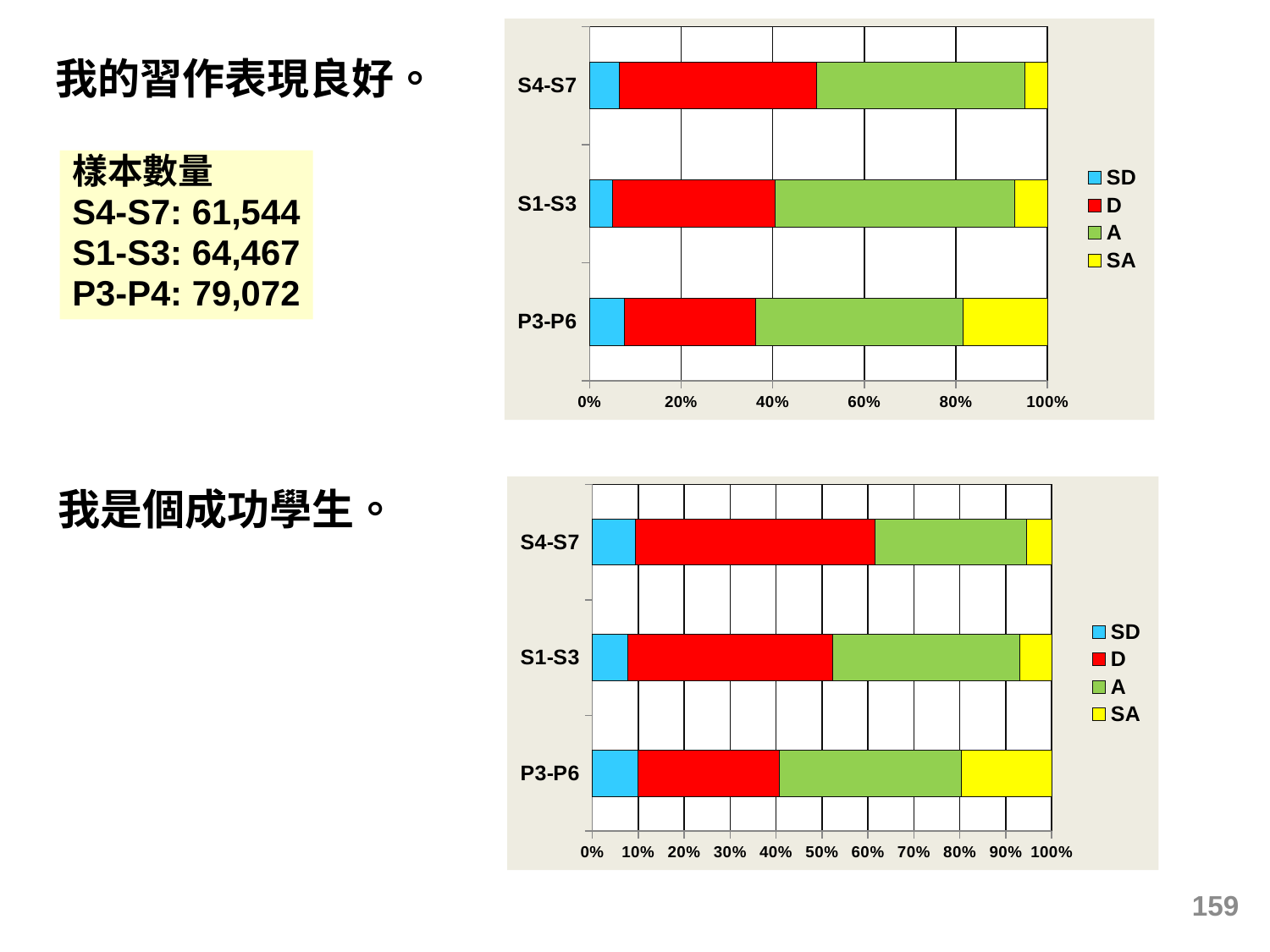
In the top chart, which category has the largest SA (yellow) segment? P3-P6 In the bottom chart, which category has the largest SA (yellow) segment? P3-P6 What are the legend entries of the bottom chart, from top to bottom? SD, D, A, SA In the bottom chart, which category has the largest D (red) segment? S4-S7 In the bottom chart, is the combined SD and D share for S4-S7 greater or less than 50%? greater What kind of chart is the top chart on the slide? Stacked bar chart What is the highest value shown on the x axis of the bottom chart? 100% How many series does the legend of the top chart list? 4 In the bottom chart, is the combined SD and D share for P3-P6 greater or less than 50%? less How many categories are shown on the y axis of the bottom chart? 3 In the top chart, is the D (red) segment larger for S4-S7 or for P3-P6? S4-S7 In the top chart, is the combined SD and D share for S4-S7 greater or less than 40%? greater